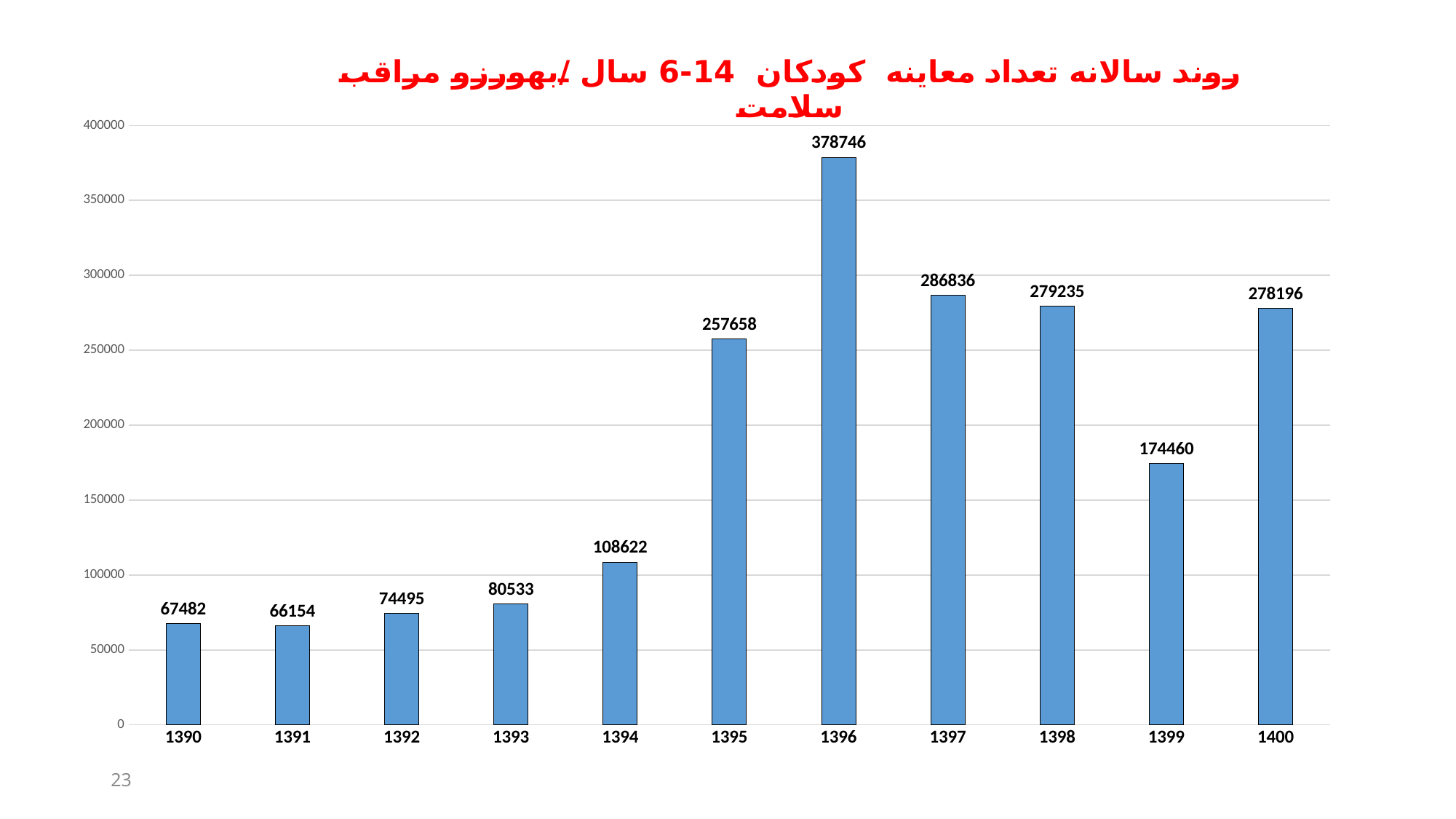
How many years are shown on the x axis? 11 What is the value for 1396? 378746 Which is larger, the value for 1394 or the value for 1393? 1394 Which year has the highest value? 1396 Do the values rise or fall from 1390 to 1396? rise What is the difference between the values for 1396 and 1395? 121088 What kind of chart is shown on the slide? bar chart What is the difference between the values for 1400 and 1399? 103736 What is the value for 1399? 174460 Which year has the lowest value? 1391 What is the value for 1390? 67482 Is the value for 1395 greater or less than 250000? greater